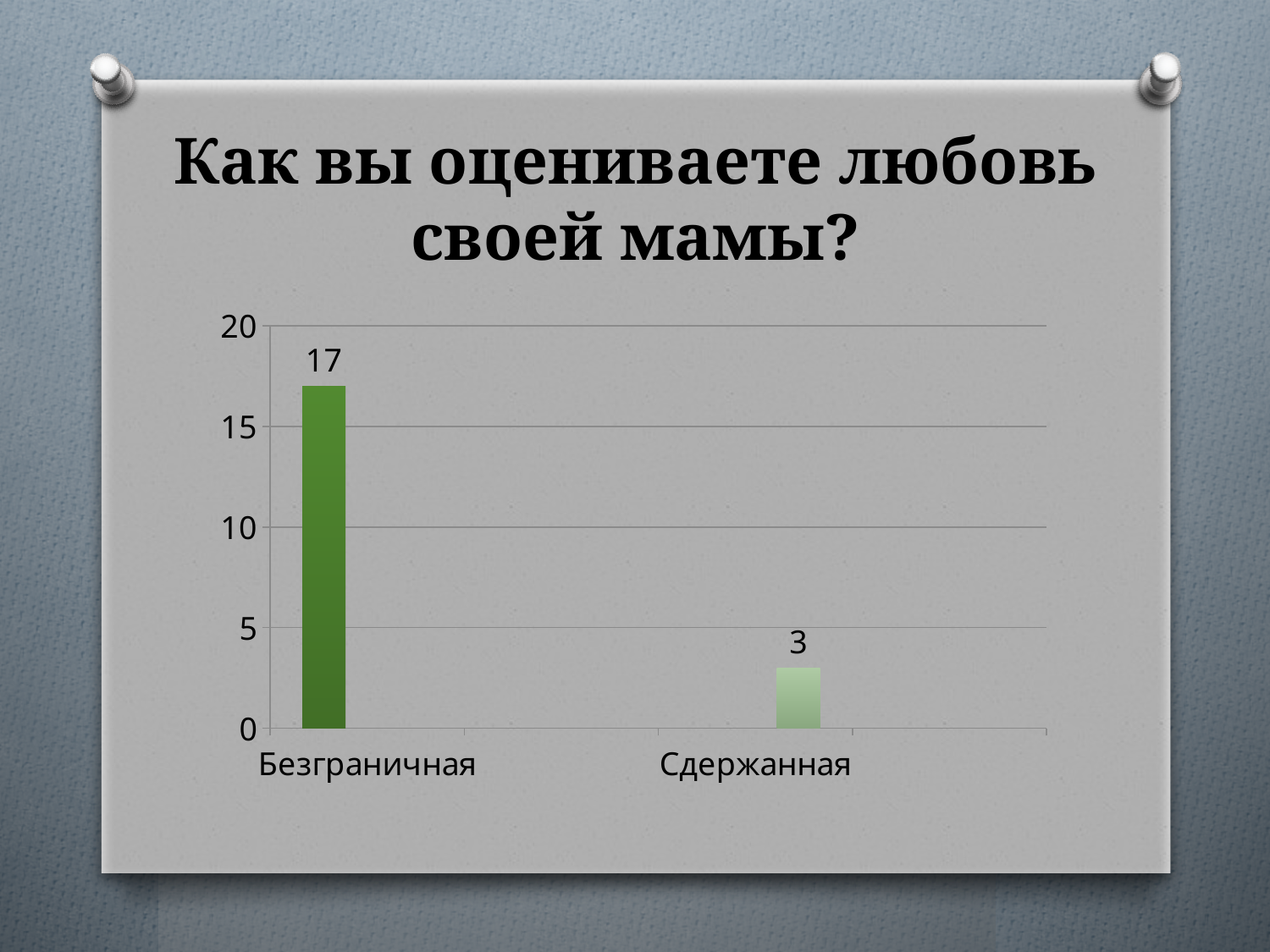
Which category has the highest value? Безграничная Is the value for Безграничная greater or less than 15? greater What is the value for Сдержанная? 3 How many categories are shown on the chart? 2 What is the title of the slide? Как вы оцениваете любовь своей мамы? What is the total of the two values shown on the chart? 20 Is the value for Сдержанная greater or less than 5? less Which is larger, the value for Безграничная or the value for Сдержанная? Безграничная Which category has the lowest value? Сдержанная What is the value for Безграничная? 17 What is the difference between the values for Безграничная and Сдержанная? 14 What kind of chart is shown on the slide? bar chart